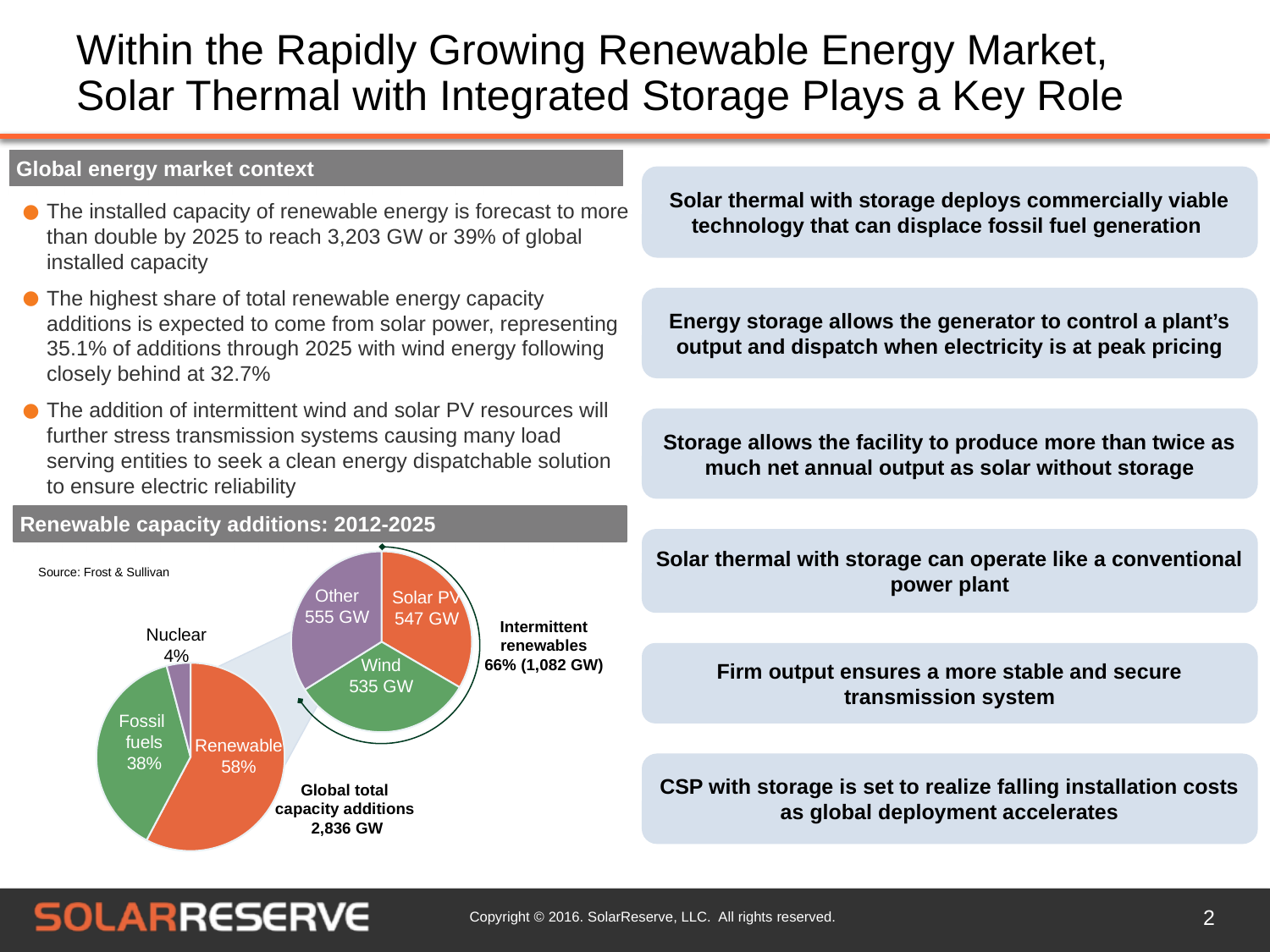
What kind of charts are shown under 'Renewable capacity additions: 2012-2025'? Pie charts In the larger pie chart (global total capacity additions), which slice is the largest? Renewable In the larger pie chart (global total capacity additions), what share is labelled for Nuclear? 4% In the larger pie chart (global total capacity additions), which slice is the smallest? Nuclear In the smaller pie chart (renewable breakdown), what value is shown for Wind? 535 GW In the larger pie chart (global total capacity additions), what share is labelled for Fossil fuels? 38% In the smaller pie chart (renewable breakdown), what value is shown for Solar PV? 547 GW In the larger pie chart (global total capacity additions), what share is labelled for Renewable? 58% In the smaller pie chart (renewable breakdown), what value is shown for Other? 555 GW In the larger pie chart (global total capacity additions), what is the difference in percentage points between Renewable and Fossil fuels? 20 percentage points In the smaller pie chart (renewable breakdown), what is the difference between Other and Wind? 20 GW In the smaller pie chart (renewable breakdown), how many slices are there? 3